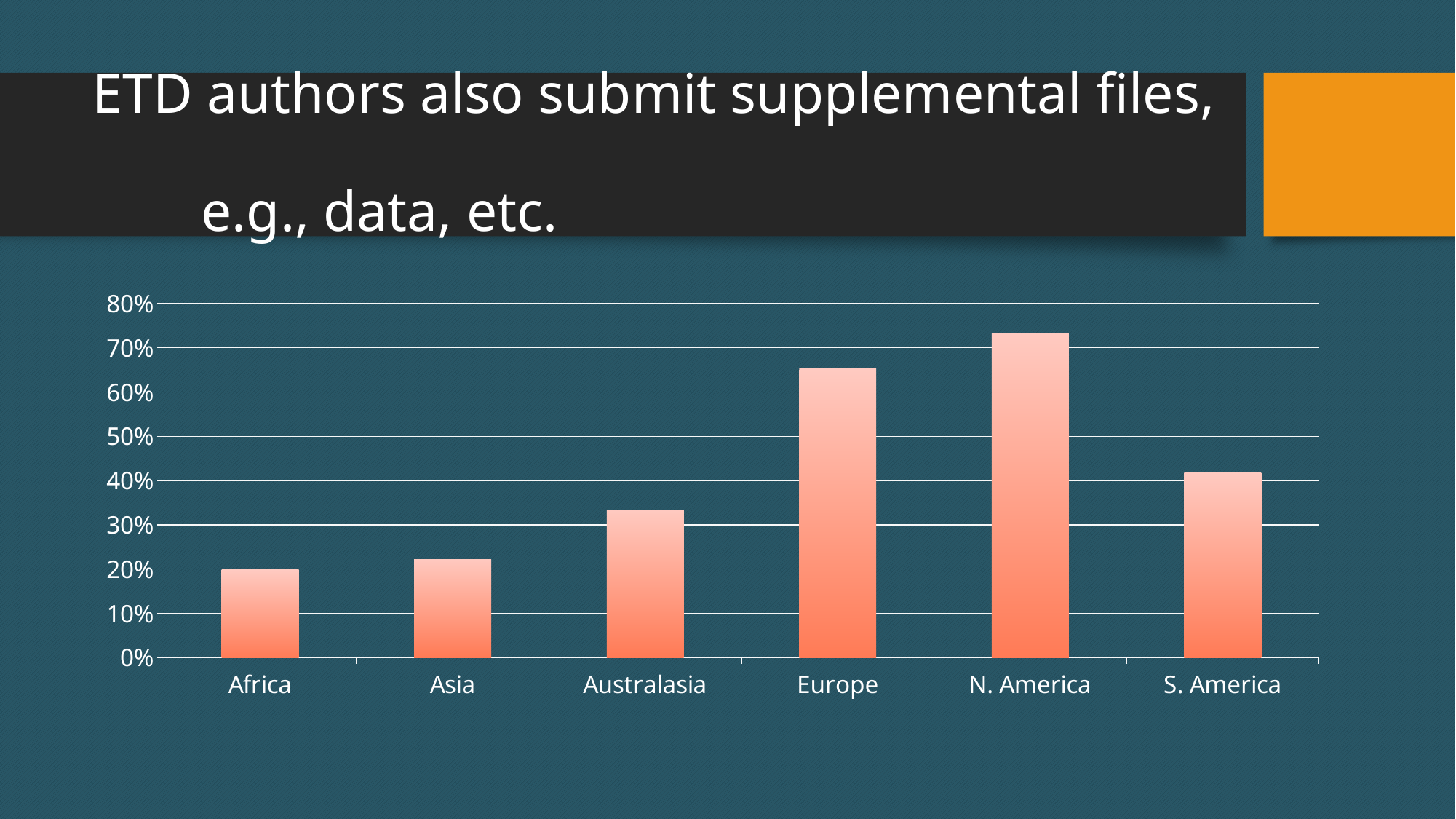
Which region has the highest bar in the chart? N. America What is the highest value shown on the chart's vertical axis? 80% Is the value for Australasia greater or less than 30%? greater Is the value for Europe greater or less than 60%? greater Which region has the lowest bar in the chart? Africa Is the value for S. America greater or less than 50%? less Which is larger, the value for Europe or the value for S. America? Europe What kind of chart is shown on the slide? bar chart Which is larger, the value for Australasia or the value for Asia? Australasia How many regions are shown on the x axis of the chart? 6